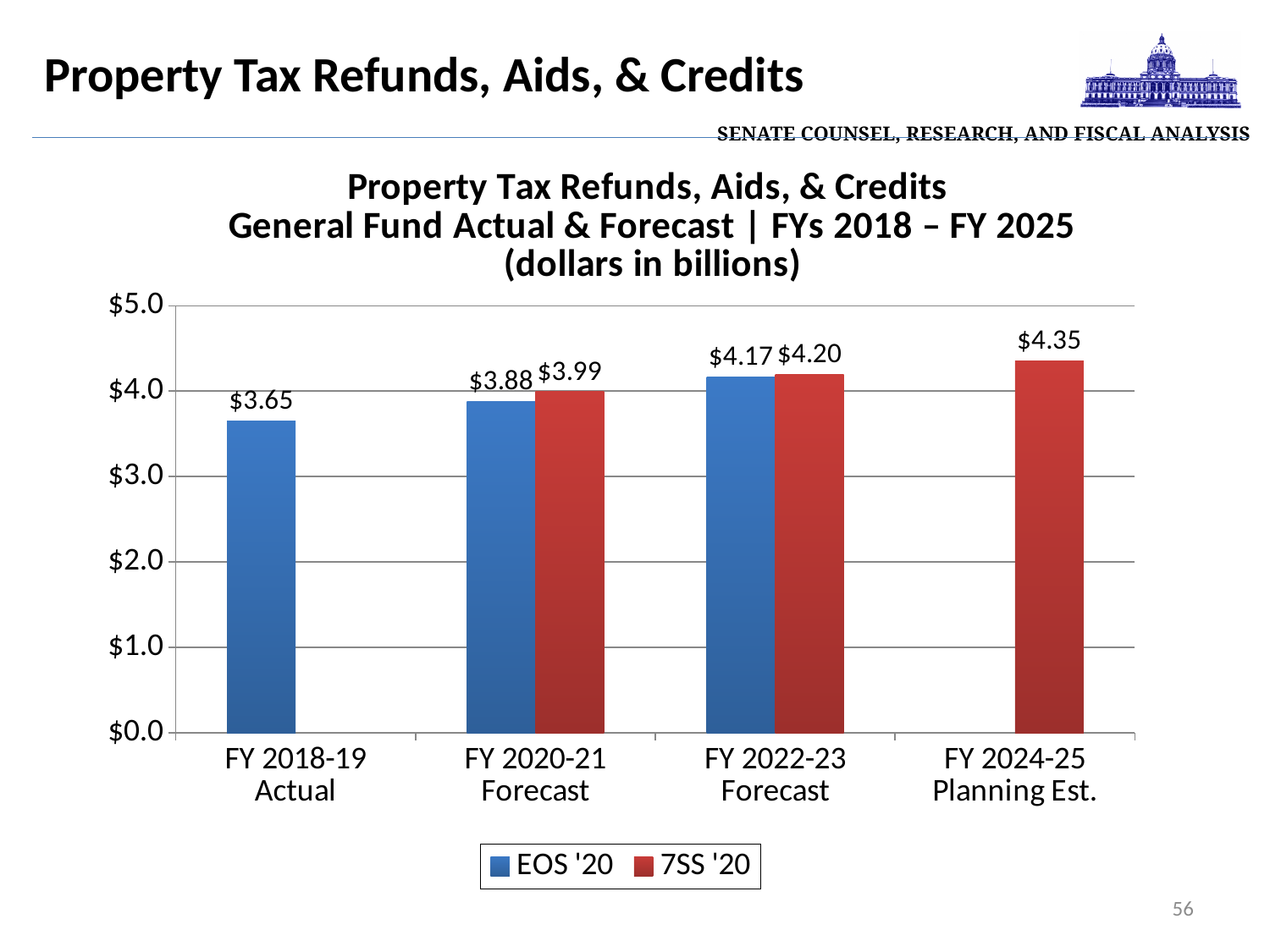
Which category has the lowest EOS '20 value? FY 2018-19 Actual What is the difference between the 7SS '20 and EOS '20 values for FY 2020-21 Forecast? $0.11 What is the 7SS '20 value for FY 2024-25 Planning Est.? $4.35 For FY 2022-23 Forecast, which is larger: the EOS '20 value or the 7SS '20 value? 7SS '20 What is the EOS '20 value for FY 2022-23 Forecast? $4.17 How many categories are shown on the x axis? 4 What is the 7SS '20 value for FY 2020-21 Forecast? $3.99 Which category has the highest 7SS '20 value? FY 2024-25 Planning Est. What kind of chart is shown on the slide? Bar chart How many series does the legend list? 2 Do the 7SS '20 values rise or fall from FY 2020-21 Forecast to FY 2024-25 Planning Est.? Rise What is the EOS '20 value for FY 2018-19 Actual? $3.65